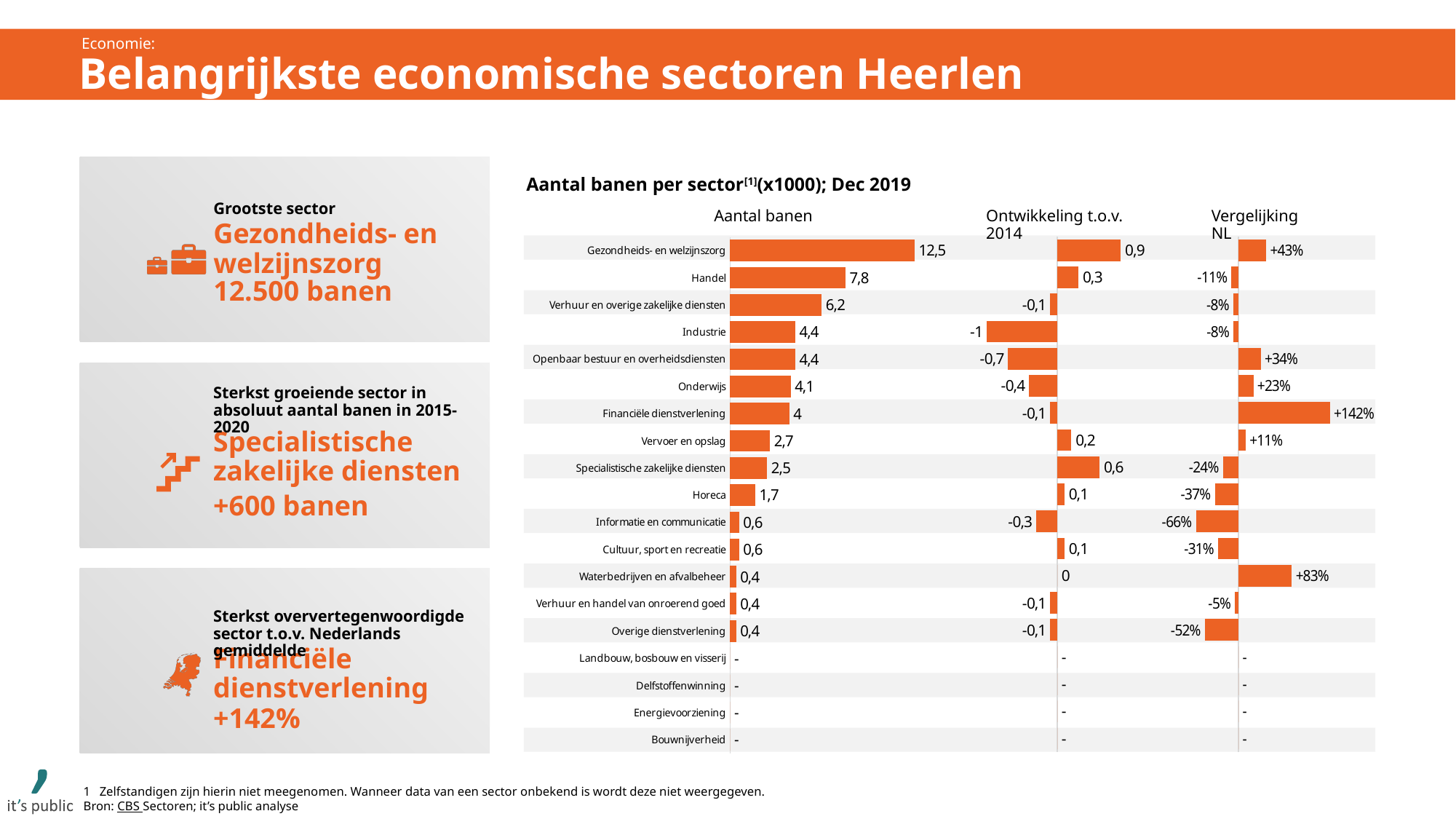
In the 'Vergelijking NL' chart, what is the value for Horeca? -37% In the 'Aantal banen' chart, what is the value for Handel? 7,8 In the 'Vergelijking NL' chart, what is the value for Financiële dienstverlening? +142% What is the title above the charts? Aantal banen per sector (x1000); Dec 2019 In the 'Ontwikkeling t.o.v. 2014' chart, what is the value for Industrie? -1 How many sectors are listed in the charts? 19 In the 'Aantal banen' chart, what is the difference between Gezondheids- en welzijnszorg and Handel? 4,7 In the 'Aantal banen' chart, which sector has the highest value? Gezondheids- en welzijnszorg In the 'Ontwikkeling t.o.v. 2014' chart, which is larger: Gezondheids- en welzijnszorg or Specialistische zakelijke diensten? Gezondheids- en welzijnszorg What kind of chart is used for 'Aantal banen'? Bar chart In the 'Ontwikkeling t.o.v. 2014' chart, what is the value for Waterbedrijven en afvalbeheer? 0 In the 'Vergelijking NL' chart, which sector has the lowest value? Informatie en communicatie